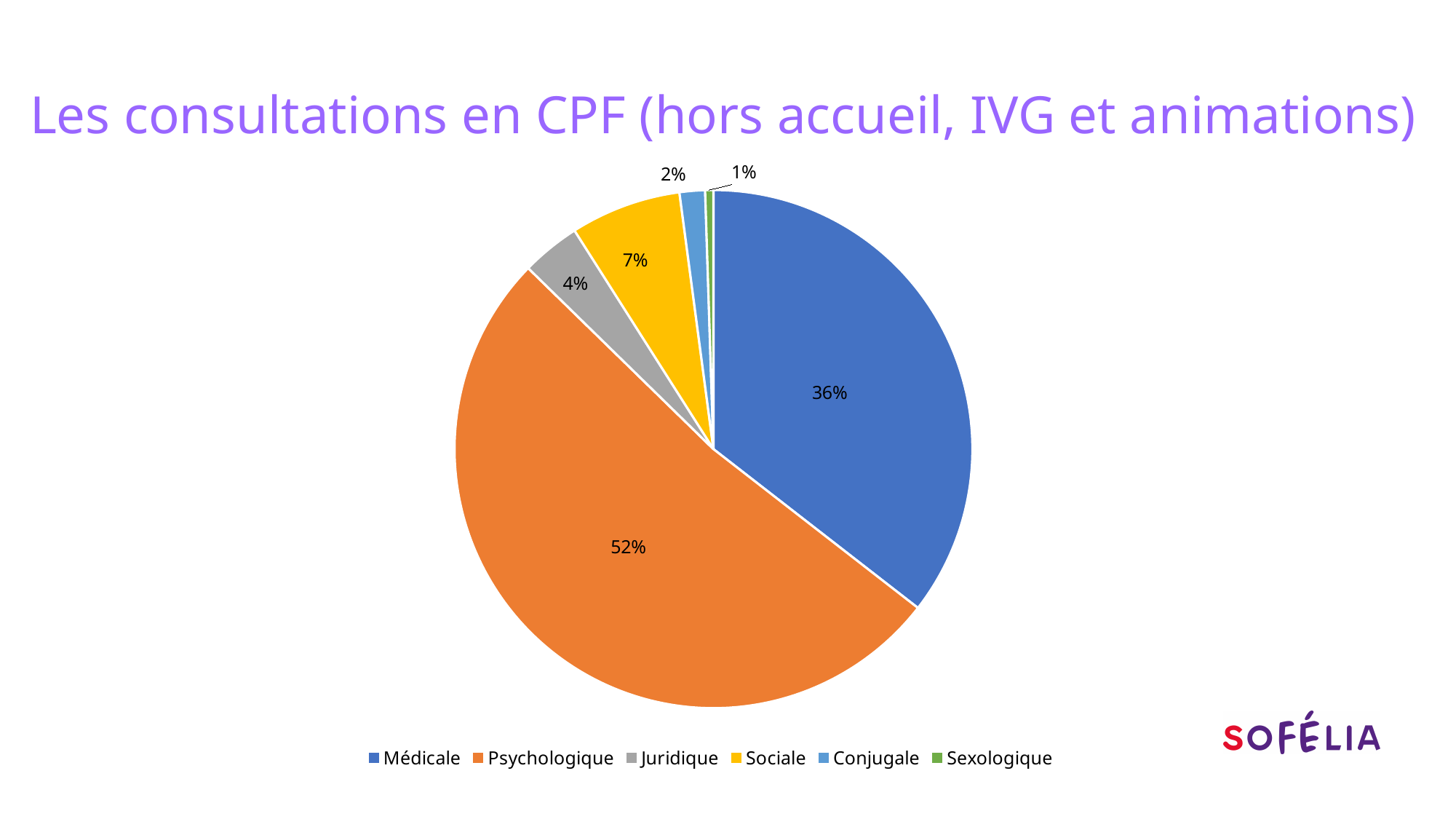
What kind of chart is shown on the slide? pie chart What is the title of the chart on the slide? Les consultations en CPF (hors accueil, IVG et animations) What is the difference in percentage points between Psychologique and Médicale? 16 What share of consultations is Psychologique? 52% Which category has the smallest share of the pie? Sexologique Which category has the largest share of the pie? Psychologique What share of consultations is Juridique? 4% What share of consultations is Médicale? 36% How many categories does the legend list? 6 What share of consultations is Conjugale? 2% Which is larger, the share for Sociale or the share for Juridique? Sociale What share of consultations is Sociale? 7%